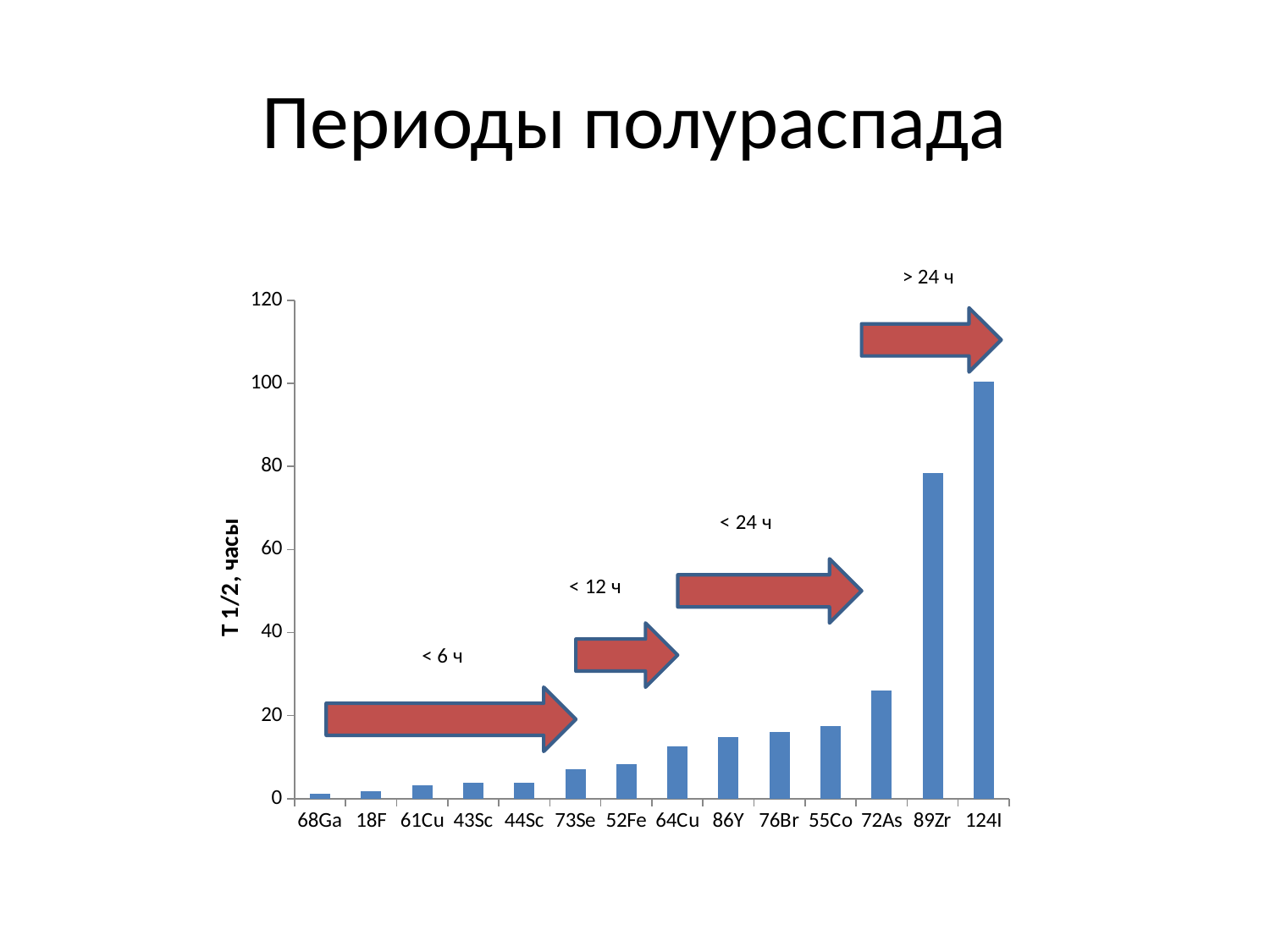
How many isotopes (categories) are plotted on the x axis? 14 What is the title of the slide? Периоды полураспада Which has the larger value, 64Cu or 73Se? 64Cu What kind of chart is shown on the slide? bar chart Which isotope has the shortest half-life (lowest bar)? 68Ga Which isotope has the longest half-life (highest bar)? 124I Is the value for 72As greater or less than 40? less Do the bar values rise or fall from left to right along the x axis? rise Is the value for 89Zr greater or less than 60? greater Which has the larger value, 89Zr or 72As? 89Zr Is the value for 55Co greater or less than 20? less What is the label of the vertical axis? T 1/2, часы